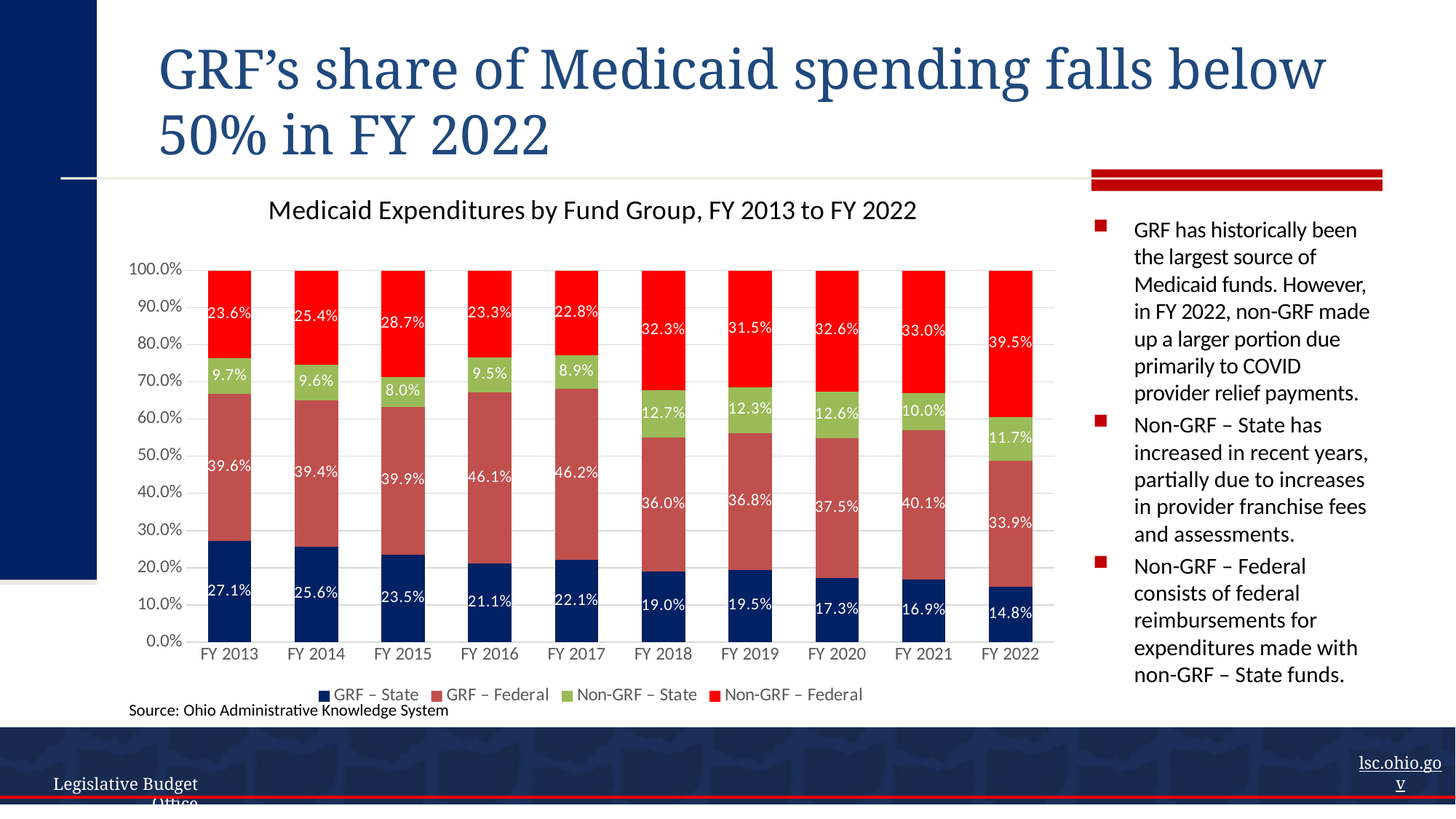
What kind of chart is shown on the slide? Stacked bar chart What is the GRF – State share of Medicaid expenditures in FY 2022? 14.8% What is the Non-GRF – Federal share in FY 2018? 32.3% In which fiscal year is the Non-GRF – Federal share the highest? FY 2022 In which fiscal year is the Non-GRF – State share the lowest? FY 2015 How many fiscal years are shown on the x axis? 10 Which is larger in FY 2020: the GRF – Federal share or the Non-GRF – Federal share? GRF – Federal What is the GRF – Federal share in FY 2017? 46.2% What is the combined GRF (State plus Federal) share of Medicaid expenditures in FY 2022? 48.7% How many series does the legend list? 4 What is the difference between the GRF – State share in FY 2013 and in FY 2022? 12.3% In which fiscal year is the GRF – State share the highest? FY 2013